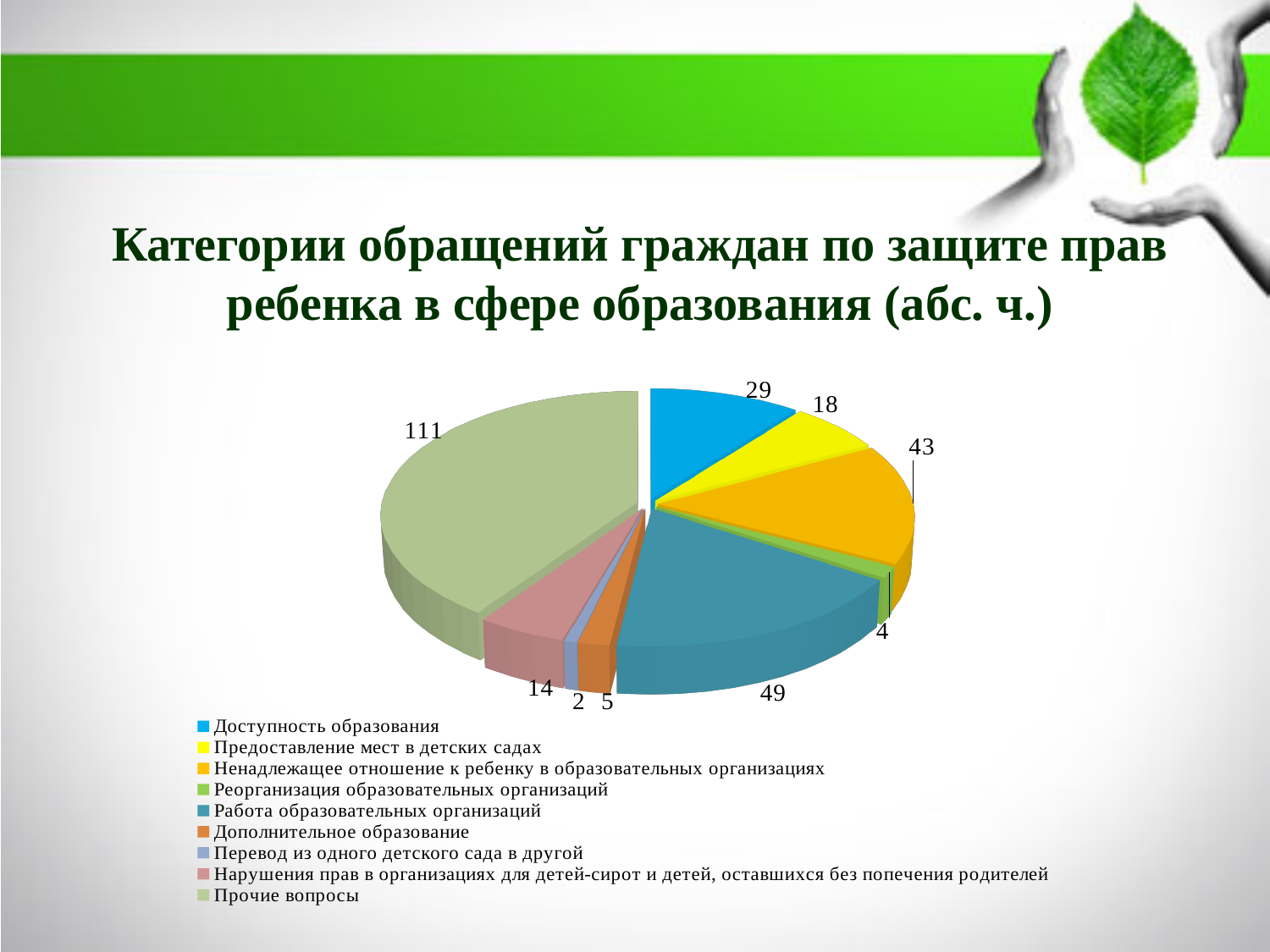
How many categories does the pie chart have? 9 What is the value for "Прочие вопросы"? 111 What is the value for "Работа образовательных организаций"? 49 What colour is the slice for "Доступность образования"? Blue What is the total of all the values shown on the pie chart? 275 Which is larger: the value for "Доступность образования" or the value for "Предоставление мест в детских садах"? Доступность образования What is the difference between the values for "Прочие вопросы" and "Работа образовательных организаций"? 62 What is the value for "Перевод из одного детского сада в другой"? 2 What kind of chart is shown on the slide? Pie chart What is the value for "Ненадлежащее отношение к ребенку в образовательных организациях"? 43 Which category has the largest slice of the pie? Прочие вопросы Which category has the smallest slice of the pie? Перевод из одного детского сада в другой